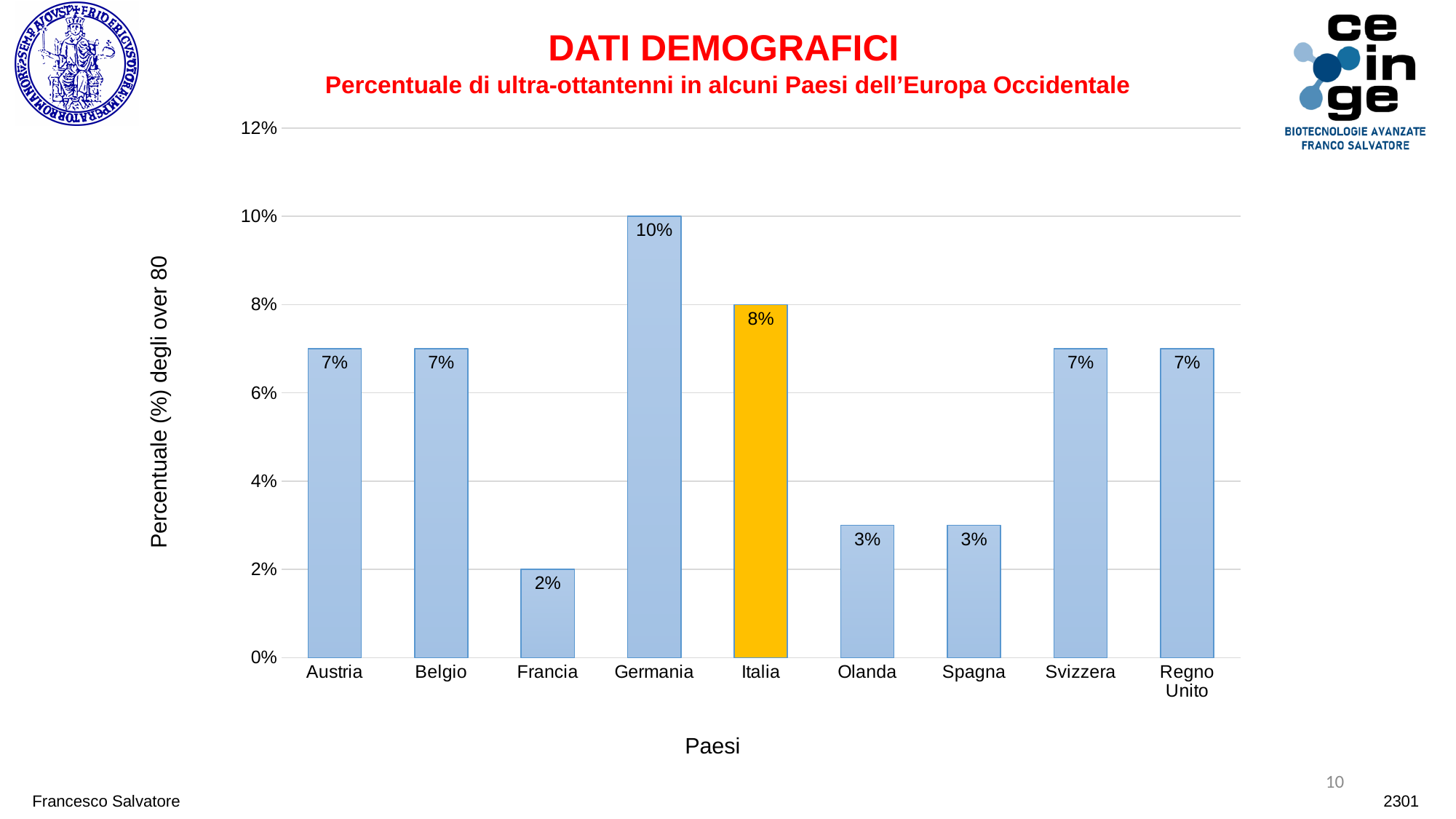
Which country has the lowest percentage of over-80s? Francia Which is larger, the value for Olanda or the value for Svizzera? Svizzera Is the value for Spagna greater or less than 4%? less What is the value for Germania? 10% How many countries are shown on the x axis? 9 What is the difference between the values for Germania and Italia? 2% What is the label of the x axis? Paesi What kind of chart is shown on the slide? bar chart What is the value for Francia? 2% Which country has the highest percentage of over-80s? Germania What is the value for Italia? 8% Which bar is highlighted in a different colour (orange) from the others? Italia